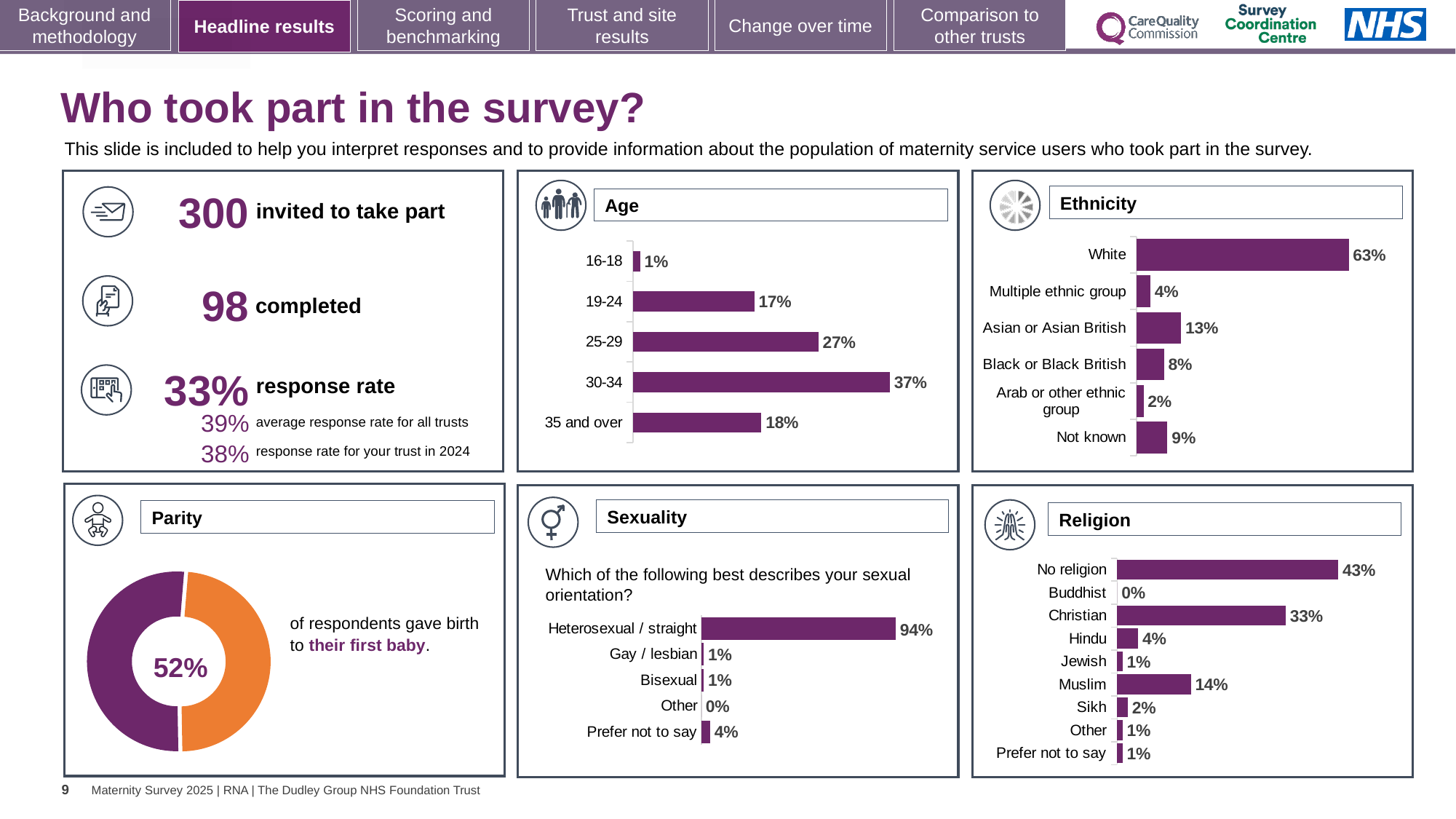
In the Age chart, what percentage of respondents were aged 30-34? 37% In the Parity chart, what share of respondents gave birth to their first baby? 52% What kind of chart is the Parity chart? Pie chart (doughnut) How many categories does the Ethnicity chart show? 6 In the Ethnicity chart, what percentage of respondents were White? 63% In the Age chart, which age group has the lowest percentage? 16-18 In the Religion chart, which category has the highest percentage? No religion In the Sexuality chart, what percentage of respondents answered Prefer not to say? 4% In the Ethnicity chart, which is larger: Asian or Asian British, or Black or Black British? Asian or Asian British In the Religion chart, what percentage of respondents were Muslim? 14% In the Religion chart, what is the difference between No religion and Christian? 10% In the Age chart, what is the difference between the 25-29 and 19-24 percentages? 10%